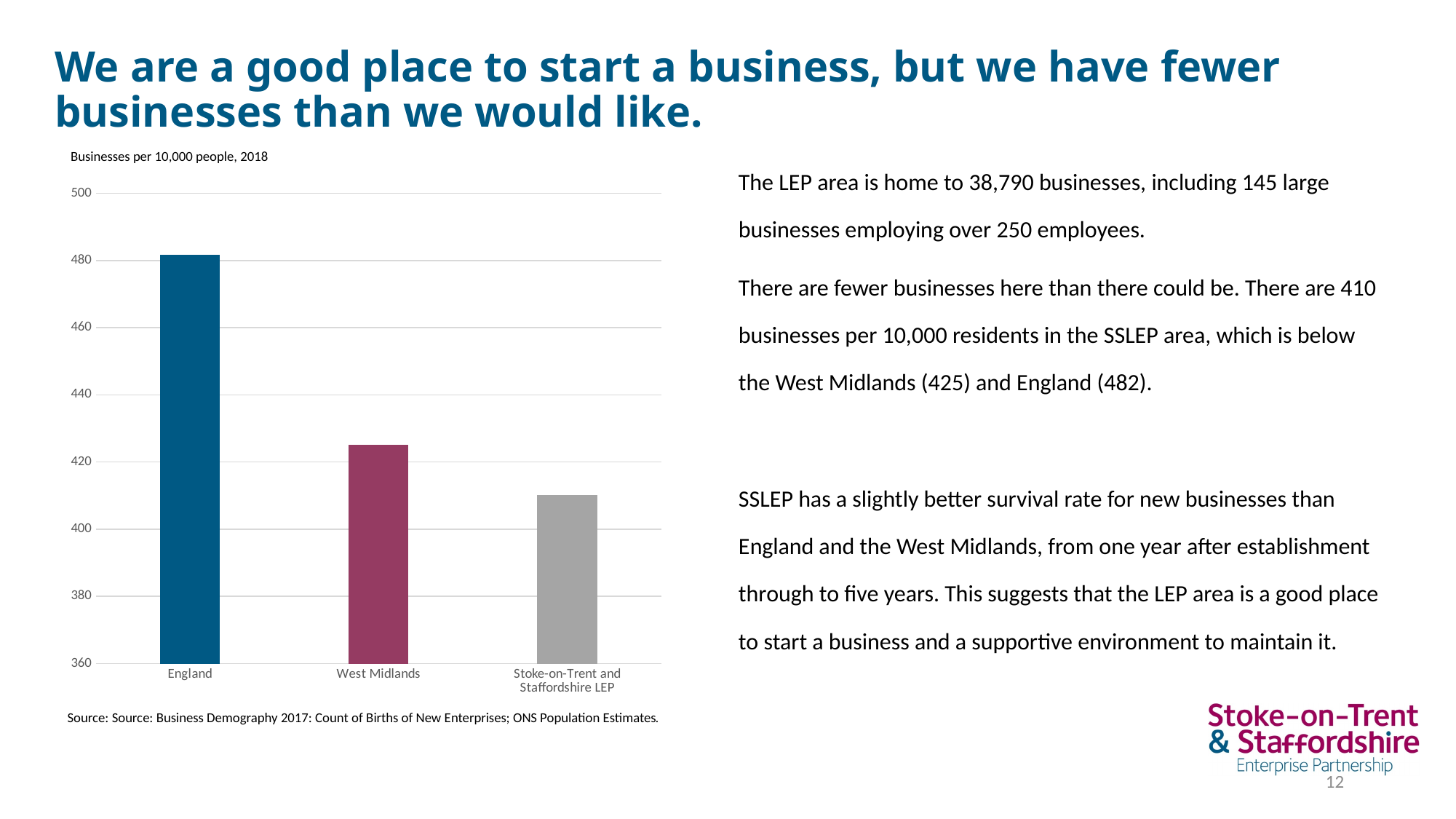
How many categories are plotted in the chart? 3 Which category has the lowest value in the chart? Stoke-on-Trent and Staffordshire LEP What kind of chart is shown on the slide? bar chart Is the value for West Midlands greater or less than 440? less Which has a larger value, West Midlands or Stoke-on-Trent and Staffordshire LEP? West Midlands What is the title of the chart? Businesses per 10,000 people, 2018 Do the bar values rise or fall from left to right across the chart? fall What colour is the bar for England? blue Which category has the highest value in the chart? England Is the value for England greater or less than 460? greater Which has a larger value, England or West Midlands? England Is the value for Stoke-on-Trent and Staffordshire LEP greater or less than 400? greater